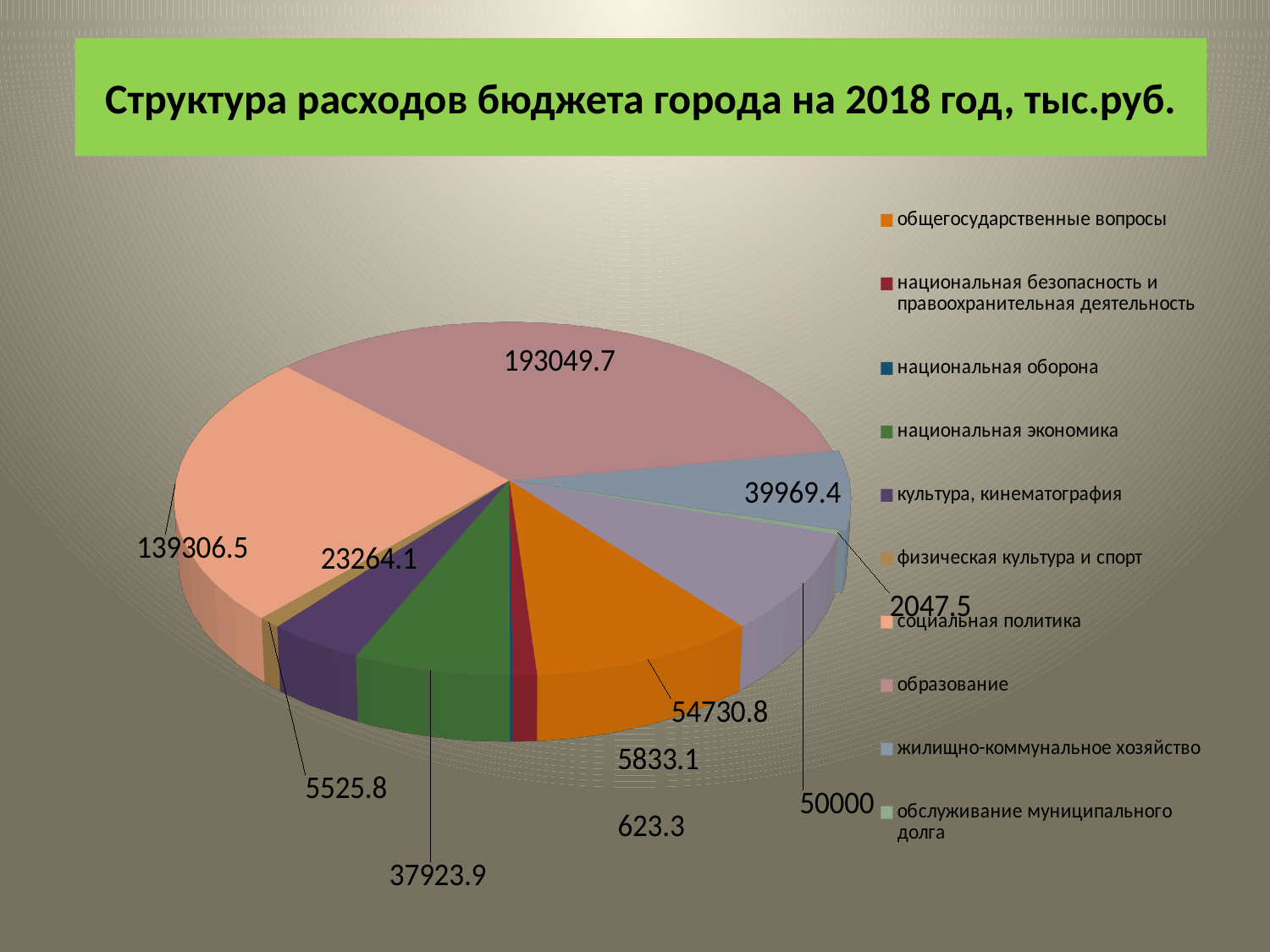
Which category has the largest slice of the pie? образование What is the value for национальная экономика? 37923.9 What is the value for обслуживание муниципального долга? 2047.5 What kind of chart is shown on the slide? pie chart How many entries does the chart's legend list? 10 What is the value for образование? 193049.7 What is the value for социальная политика? 139306.5 What is the value for культура, кинематография? 23264.1 What is the title of the chart? Структура расходов бюджета города на 2018 год, тыс.руб. Which is larger: the value for жилищно-коммунальное хозяйство or the value for национальная экономика? жилищно-коммунальное хозяйство Which category has the smallest slice of the pie? национальная оборона What is the difference between the values for образование and социальная политика? 53743.2